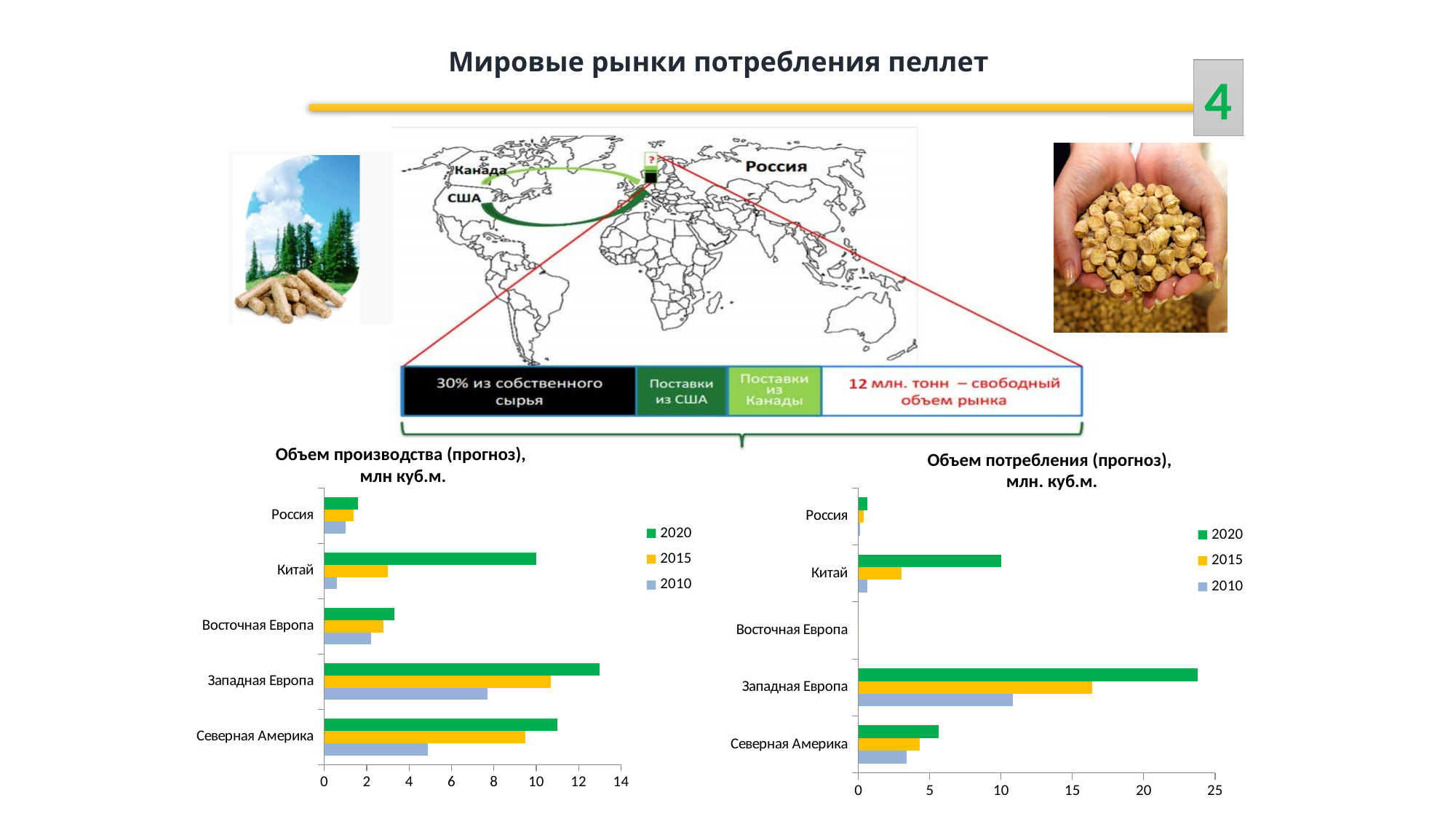
In the 'Объем производства (прогноз), млн куб.м.' chart, which region has the lowest 2020 value? Россия In the 'Объем производства (прогноз), млн куб.м.' chart, how many regions are shown on the category axis? 5 In the 'Объем производства (прогноз), млн куб.м.' chart, which region has the highest 2020 value? Западная Европа In the 'Объем производства (прогноз), млн куб.м.' chart, is the 2010 value for Северная Америка greater or less than 6? less In the 'Объем производства (прогноз), млн куб.м.' chart, which is larger for 2020: Северная Америка or Китай? Северная Америка In the 'Объем потребления (прогноз), млн. куб.м.' chart, is the 2010 value for Северная Америка greater or less than 5? less In the 'Объем потребления (прогноз), млн. куб.м.' chart, do the values for Западная Европа rise or fall from 2010 to 2020? rise In the 'Объем потребления (прогноз), млн. куб.м.' chart, which region has the highest 2020 value? Западная Европа In the 'Объем производства (прогноз), млн куб.м.' chart, how many series does the legend list? 3 In the 'Объем потребления (прогноз), млн. куб.м.' chart, is the 2020 value for Западная Европа greater or less than 20? greater What kind of chart is the 'Объем производства (прогноз), млн куб.м.' chart? bar chart